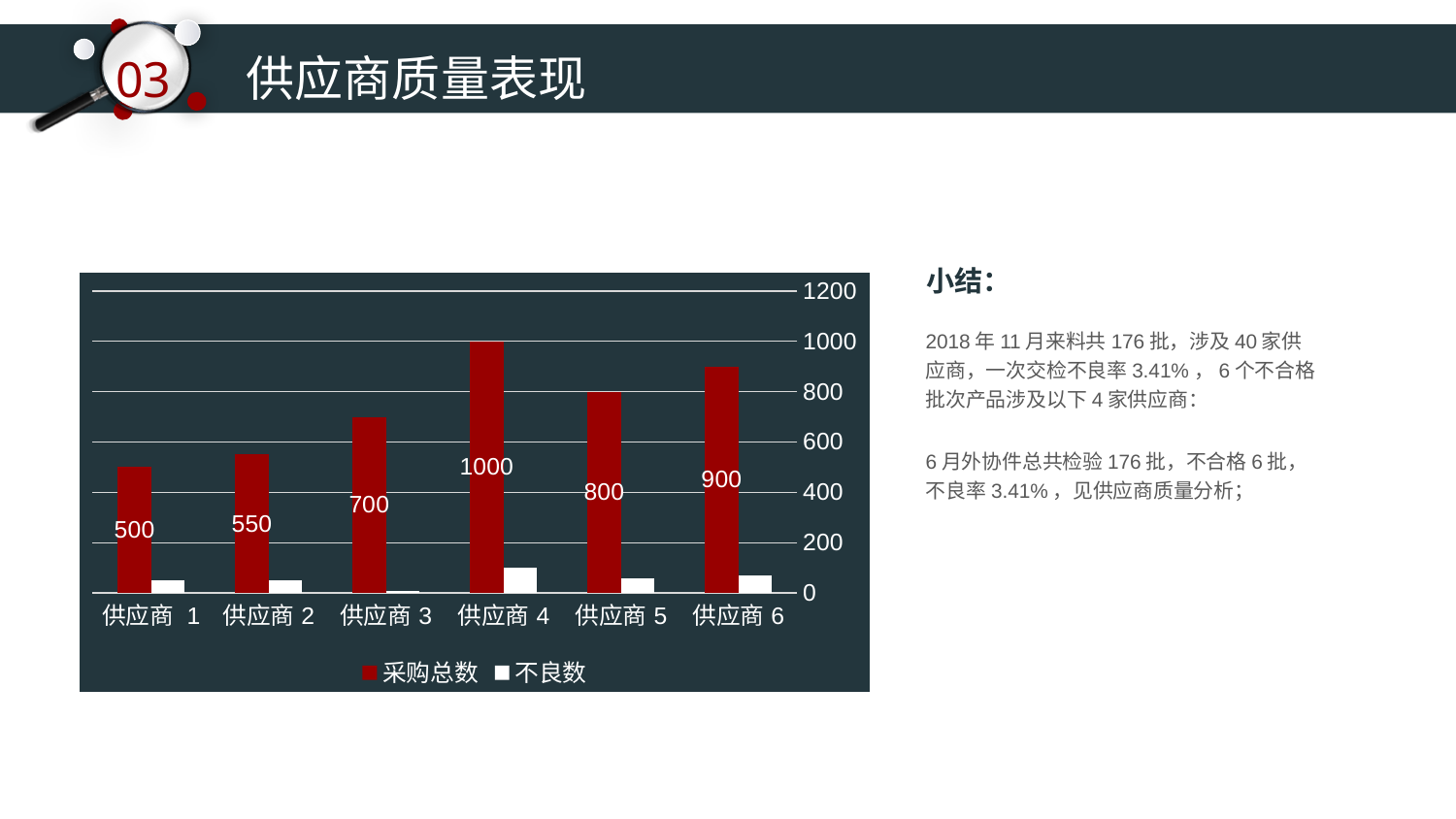
What is the difference in 采购总数 between 供应商 4 and 供应商 1? 500 Which series is shown in red in the legend? 采购总数 Which supplier has the highest 采购总数? 供应商 4 What is the 采购总数 value for 供应商 4? 1000 What is the 采购总数 value for 供应商 2? 550 How many series does the legend list? 2 What is the 采购总数 value for 供应商 6? 900 Which has a larger 采购总数, 供应商 3 or 供应商 5? 供应商 5 Is the 不良数 value for 供应商 4 greater or less than 200? less Which supplier has the lowest 采购总数? 供应商 1 How many suppliers are shown on the x axis? 6 What kind of chart is shown on the slide? bar chart